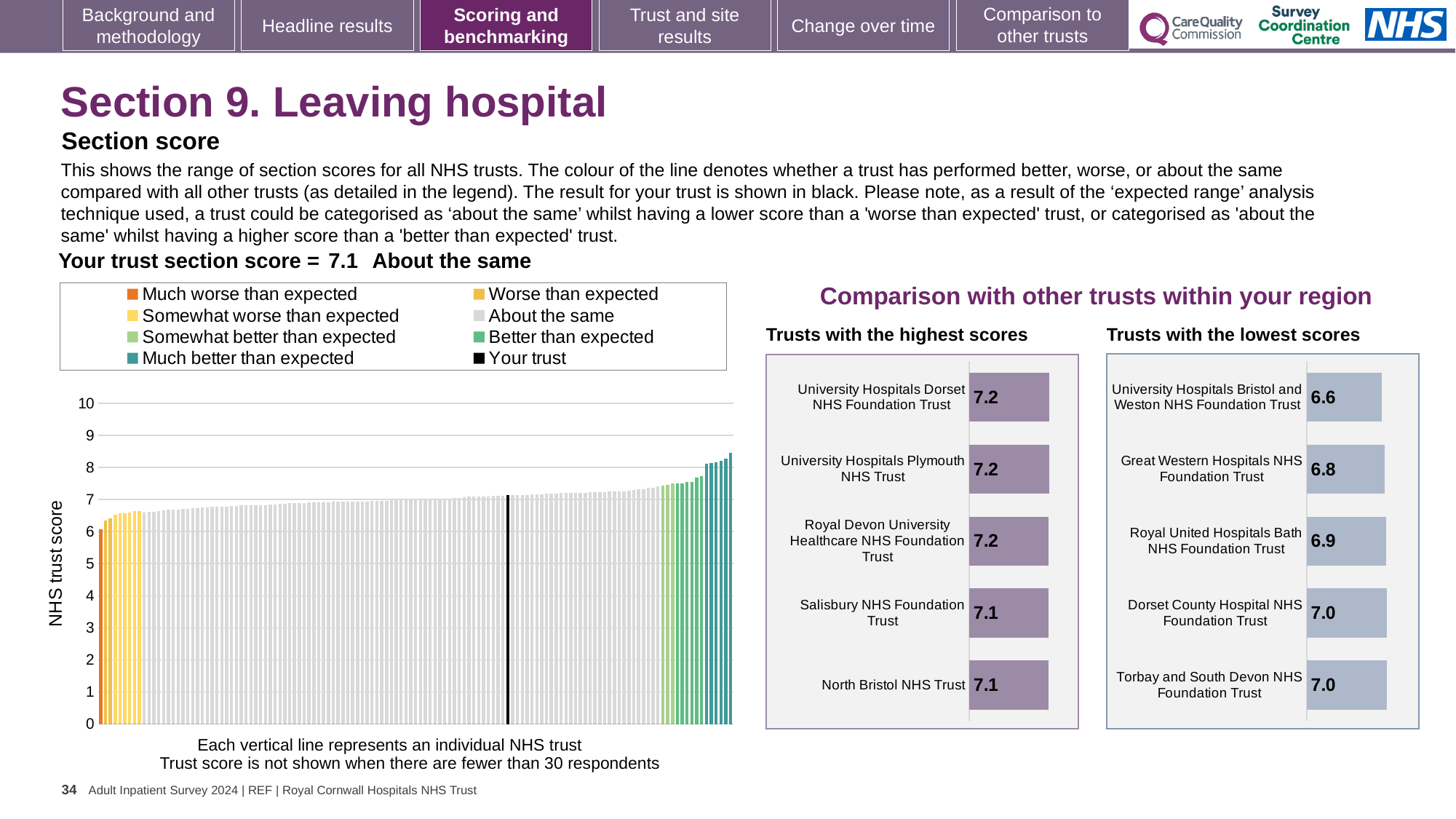
In the 'Trusts with the highest scores' chart, what is the score for Salisbury NHS Foundation Trust? 7.1 In the main section score chart on the left, is the value for the lowest-scoring trust greater or less than 7? less In the main section score chart on the left, what is the section score for your trust? 7.1 How many entries does the legend of the main section score chart on the left list? 8 How many trusts are shown in the 'Trusts with the highest scores' chart? 5 What kind of chart is the 'Trusts with the highest scores' chart? Bar chart In the 'Trusts with the lowest scores' chart, which has the higher score: Great Western Hospitals NHS Foundation Trust or Royal United Hospitals Bath NHS Foundation Trust? Royal United Hospitals Bath NHS Foundation Trust In the 'Trusts with the lowest scores' chart, what is the score for Great Western Hospitals NHS Foundation Trust? 6.8 In the 'Trusts with the lowest scores' chart, what is the difference between the scores of Royal United Hospitals Bath NHS Foundation Trust and University Hospitals Bristol and Weston NHS Foundation Trust? 0.3 How many trusts are shown in the 'Trusts with the lowest scores' chart? 5 In the 'Trusts with the lowest scores' chart, what is the difference between the scores of Dorset County Hospital NHS Foundation Trust and University Hospitals Bristol and Weston NHS Foundation Trust? 0.4 In the 'Trusts with the lowest scores' chart, which trust has the lowest score? University Hospitals Bristol and Weston NHS Foundation Trust